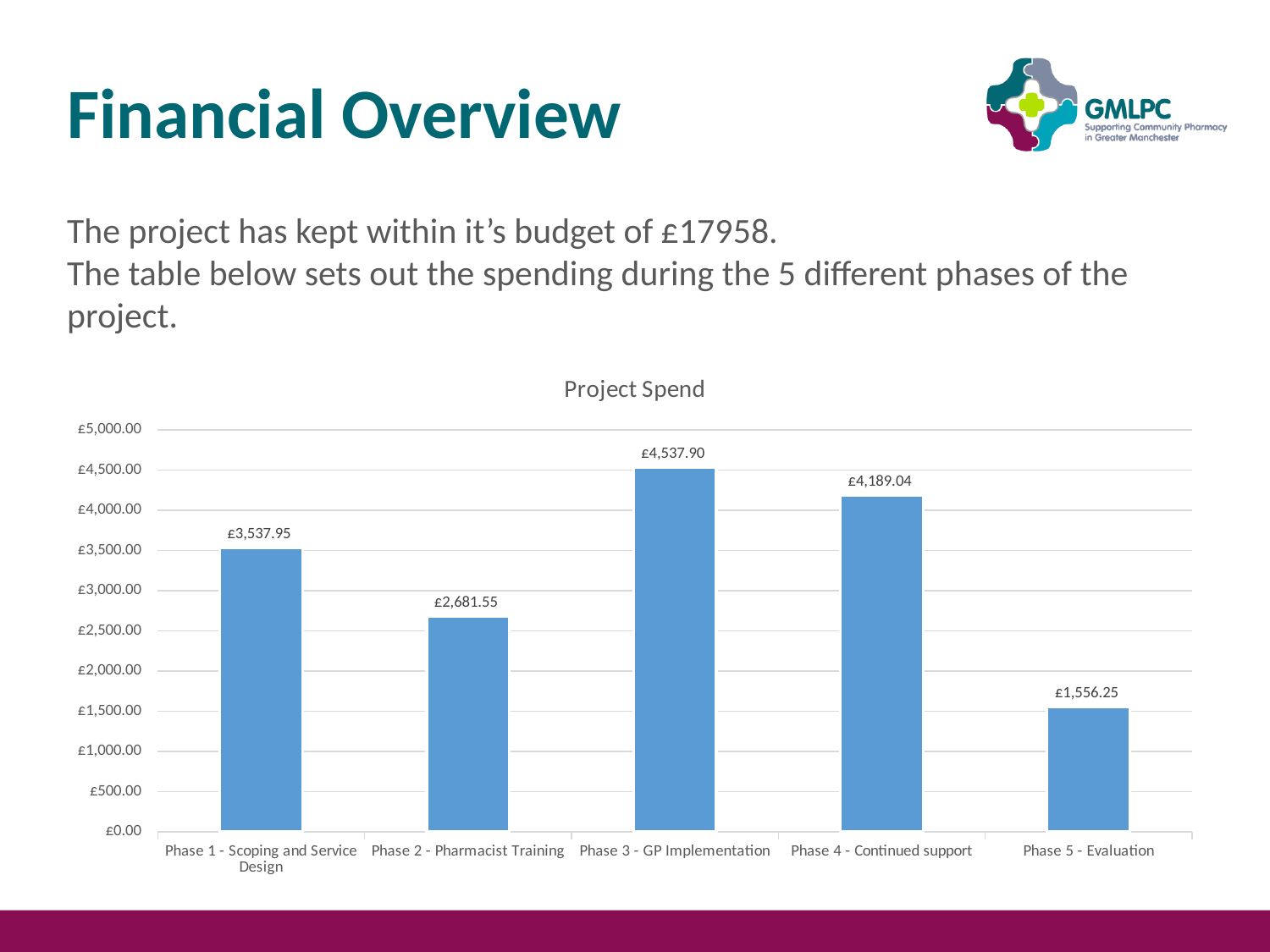
What is the value for Phase 5 - Evaluation in the Project Spend chart? £1,556.25 What is the difference between the spend for Phase 1 - Scoping and Service Design and Phase 2 - Pharmacist Training? £856.40 Which phase has the highest spend? Phase 3 - GP Implementation What is the value for Phase 3 - GP Implementation in the Project Spend chart? £4,537.90 Which is larger, the spend for Phase 4 - Continued support or Phase 1 - Scoping and Service Design? Phase 4 - Continued support What type of chart is used to show Project Spend? Bar chart What is the difference between the spend for Phase 3 - GP Implementation and Phase 4 - Continued support? £348.86 Which phase has the lowest spend? Phase 5 - Evaluation What is the value for Phase 1 - Scoping and Service Design? £3,537.95 What is the value for Phase 2 - Pharmacist Training? £2,681.55 How many phases are shown in the Project Spend chart? 5 Is the value for Phase 2 - Pharmacist Training greater or less than £3,000.00? less